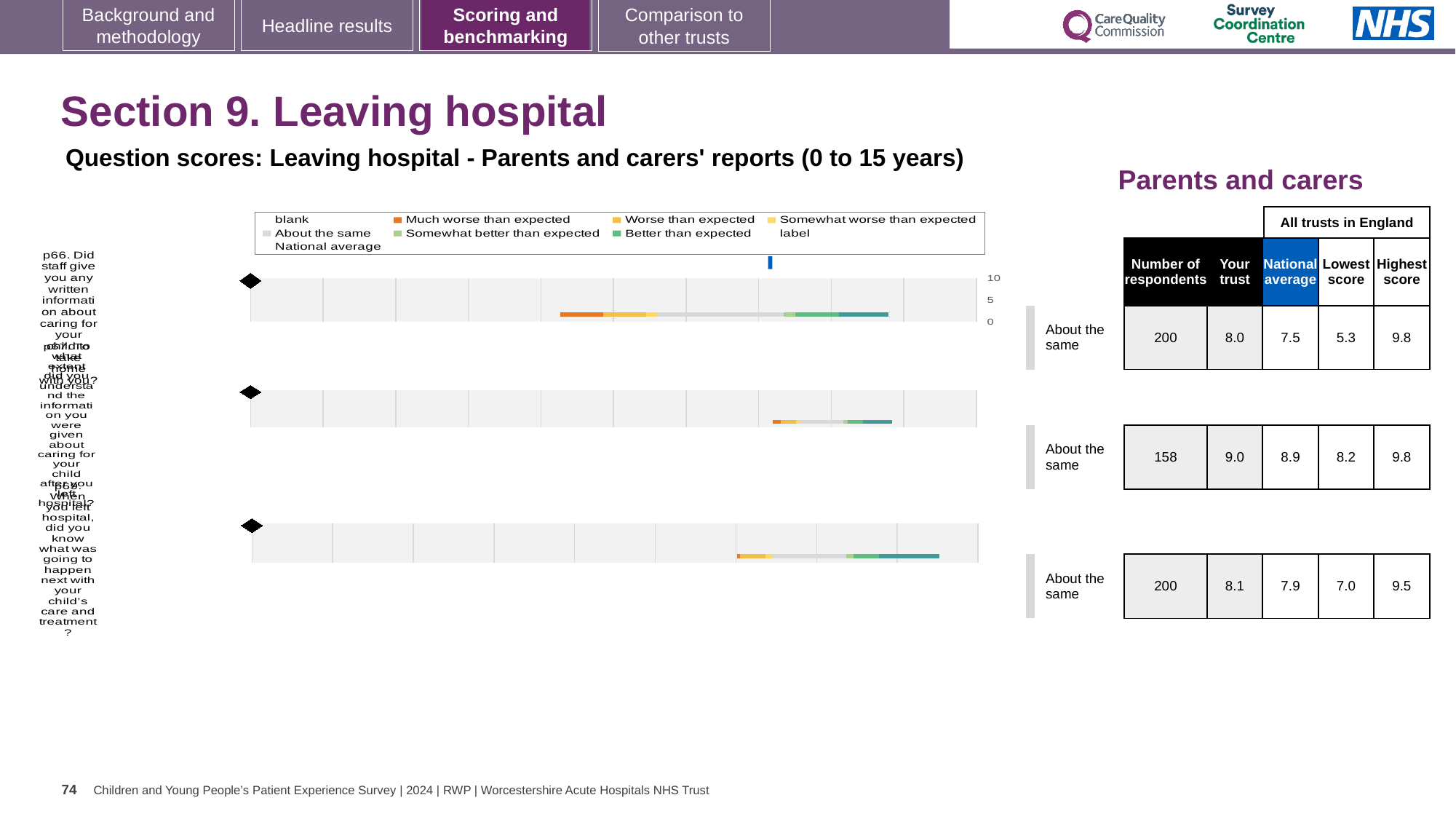
What kind of chart is shown on the slide? bar chart How many entries does the chart legend list? 9 Which of the three questions has the highest 'Your trust' score in the table? the second (middle) question, 9.0 In the table, what is the lowest score for the second (middle) question? 8.2 In the table, what is the number of respondents for the first (top) question? 200 In the table, what is the national average for the third (bottom) question? 7.9 Which is larger: the highest score for the first (top) question or for the third (bottom) question? the first (top) question, 9.8 What colour does the legend use for 'Much worse than expected'? orange What benchmark category is shown next to each of the three bars? About the same How many question bars are plotted in the chart? 3 For the first (top) question, what is the difference between the 'Your trust' score and the national average? 0.5 In the table, what is the 'Your trust' score for the second (middle) question? 9.0